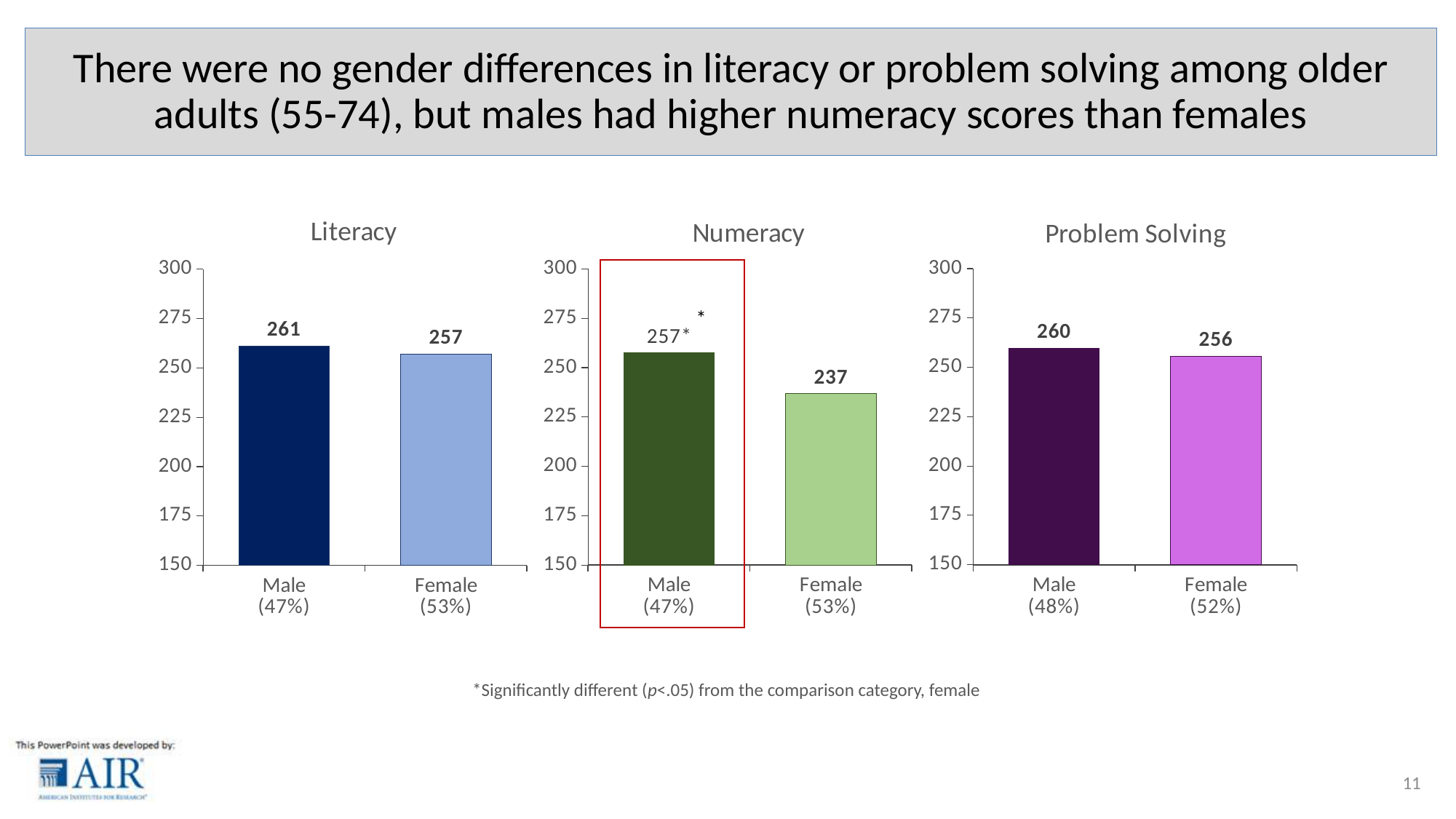
In the Numeracy chart, which category has the lowest value? Female (53%) In the Numeracy chart, what is the difference between the Male and Female values? 20 In the Literacy chart, what is the difference between the Male and Female values? 4 What kind of chart is the Problem Solving chart? bar chart In the Problem Solving chart, what is the value for Male (48%)? 260 In the Numeracy chart, is the value for Female (53%) greater or less than 250? less In the Literacy chart, what is the value for Female (53%)? 257 In the Numeracy chart, what is the value for Male (47%)? 257 In the Numeracy chart, what is the value for Female (53%)? 237 In the Problem Solving chart, what is the value for Female (52%)? 256 How many categories does the Literacy chart show? 2 In the Literacy chart, what is the value for Male (47%)? 261